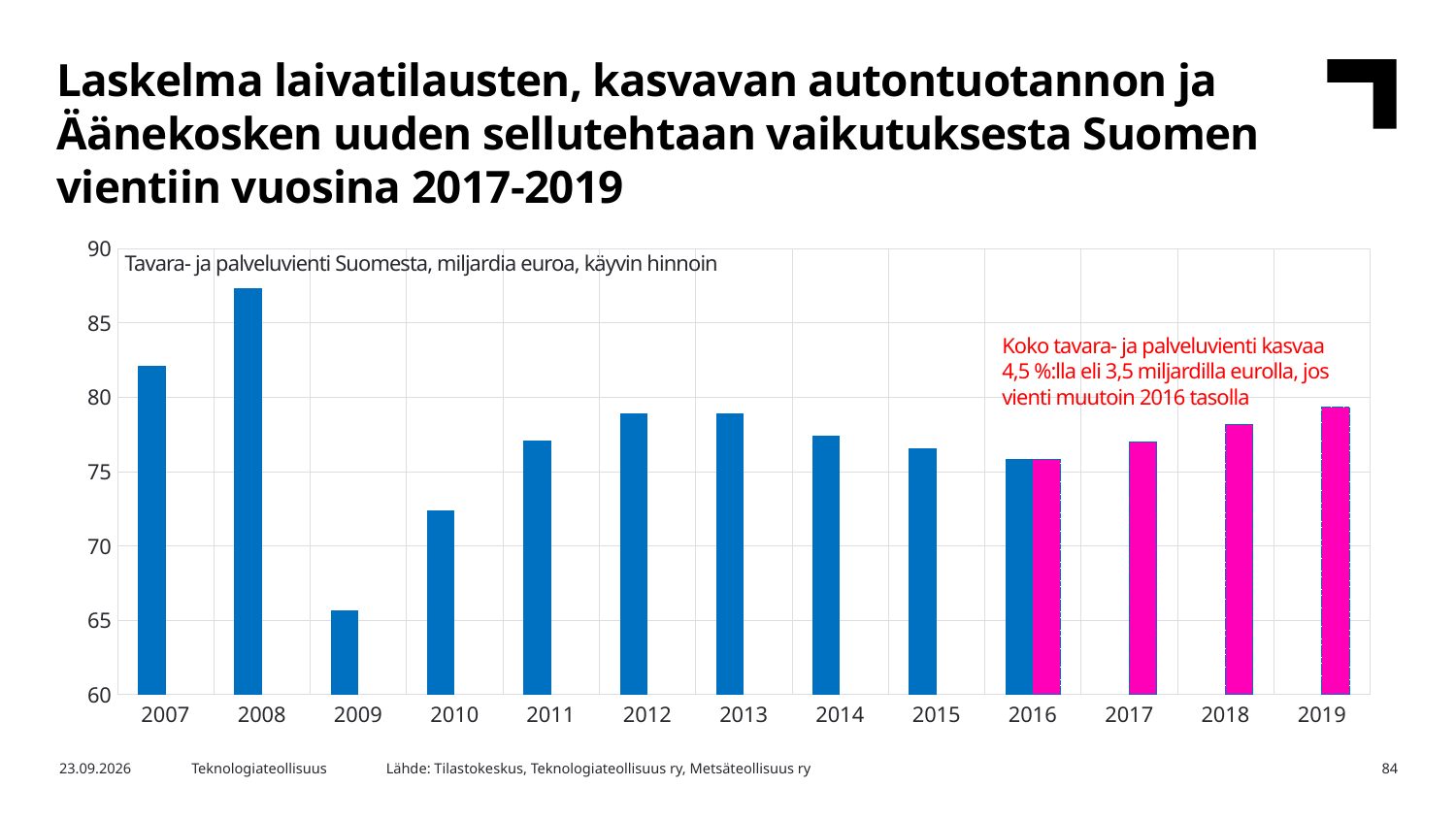
Which is larger, the value for 2016 or the value for 2018? 2018 Is the value for 2019 greater or less than 80? less Is the value for 2007 greater or less than 80? greater What text is shown inside the chart area at the top left describing the data? Tavara- ja palveluvienti Suomesta, miljardia euroa, käyvin hinnoin Is the value for 2008 greater or less than 85? greater How many years are shown on the x axis of the chart? 13 Which year has the highest value in the chart? 2008 Which is larger, the value for 2007 or the value for 2010? 2007 Do the values rise or fall from 2016 to 2019? rise What kind of chart is shown on the slide? bar chart Which year has the lowest value in the chart? 2009